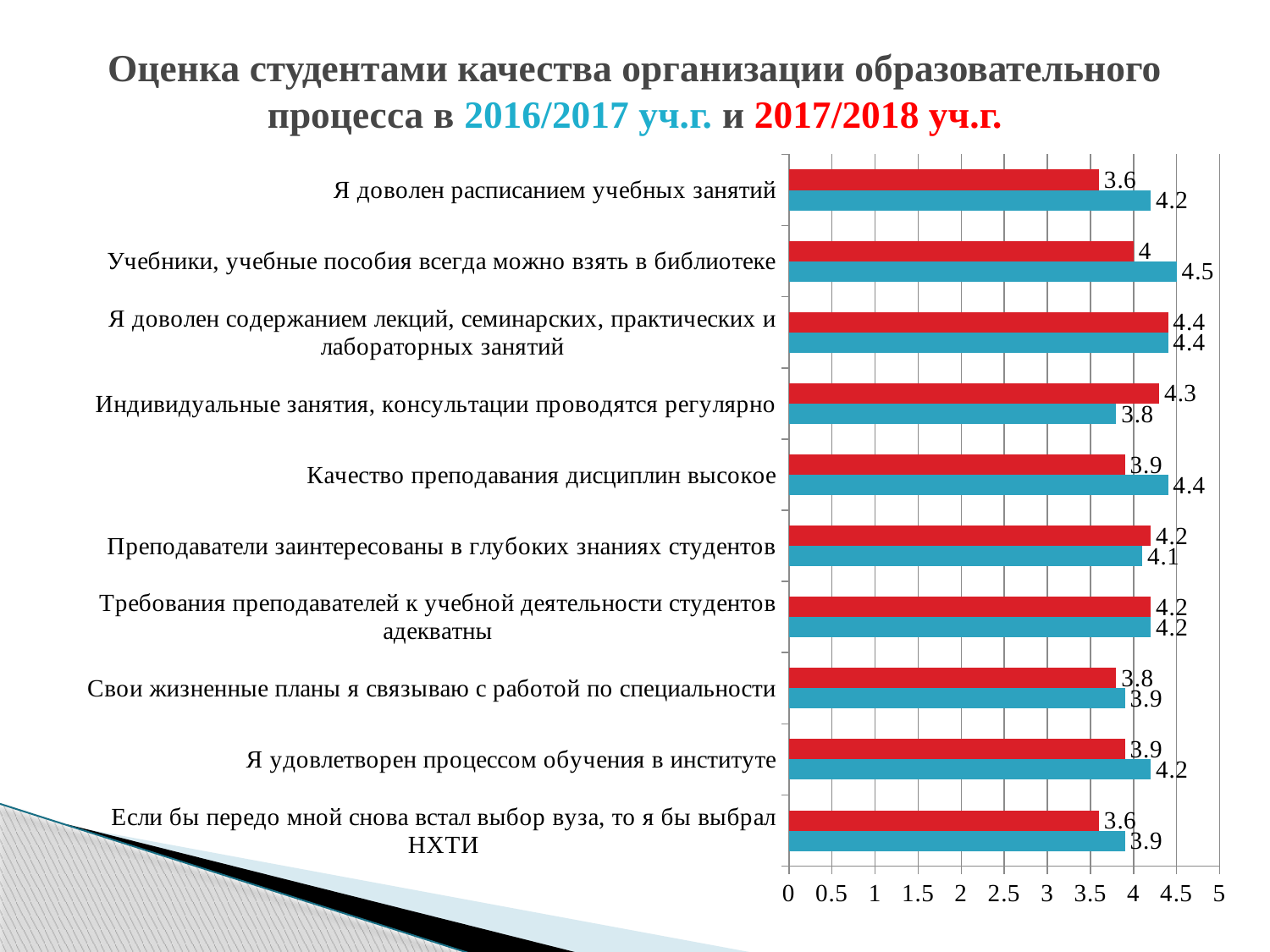
What is the value of the blue bar for 'Индивидуальные занятия, консультации проводятся регулярно'? 3.8 Is the red bar value for 'Если бы передо мной снова встал выбор вуза, то я бы выбрал НХТИ' greater or less than 4? less How many categories (statements) are plotted in the chart? 10 What is the value of the blue bar for 'Учебники, учебные пособия всегда можно взять в библиотеке'? 4.5 According to the slide title, which academic year is shown in red? 2017/2018 уч.г. Which category has the lowest blue bar value? Индивидуальные занятия, консультации проводятся регулярно What is the value of the red bar for 'Качество преподавания дисциплин высокое'? 3.9 What is the difference between the blue and red bar values for 'Я доволен расписанием учебных занятий'? 0.6 What type of chart is shown on the slide? bar chart Which category has the highest blue bar value? Учебники, учебные пособия всегда можно взять в библиотеке What is the value of the red bar for 'Я доволен расписанием учебных занятий'? 3.6 For 'Индивидуальные занятия, консультации проводятся регулярно', which bar is larger, the red or the blue? red